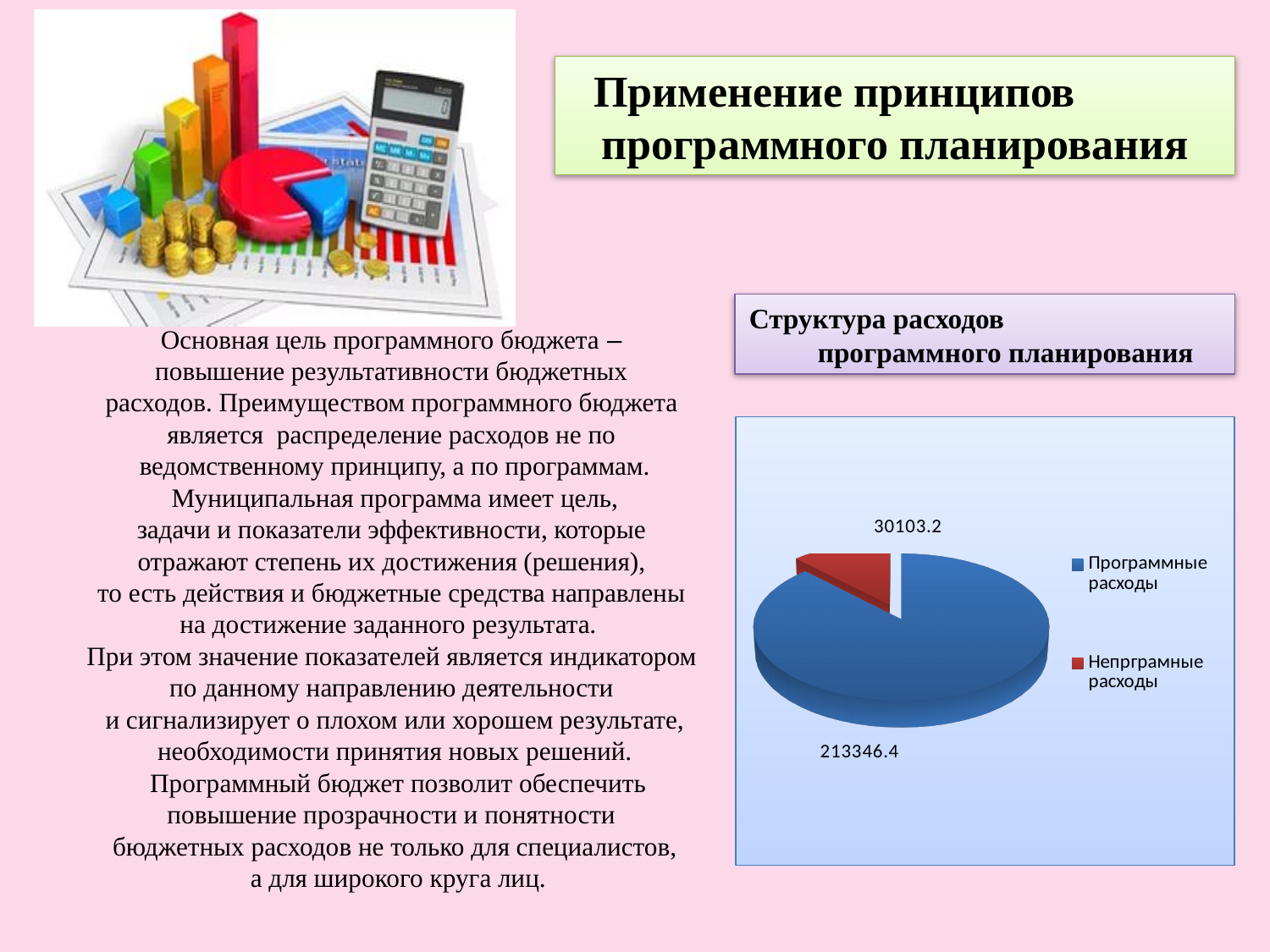
What is the title shown above the pie chart? Структура расходов программного планирования How many slices does the pie chart have? 2 What kind of chart is shown on the slide? pie chart What is the total of the two values shown in the pie chart? 243449.6 Which category has the smallest slice in the pie chart? Непрграмные расходы What is the difference between Программные расходы and Непрграмные расходы in the pie chart? 183243.2 What is the value for Непрграмные расходы in the pie chart? 30103.2 Which category has the largest slice in the pie chart? Программные расходы What colour is the slice for Непрграмные расходы in the pie chart? red Which is larger in the pie chart: Программные расходы or Непрграмные расходы? Программные расходы How many entries does the legend of the pie chart list? 2 What is the value for Программные расходы in the pie chart? 213346.4